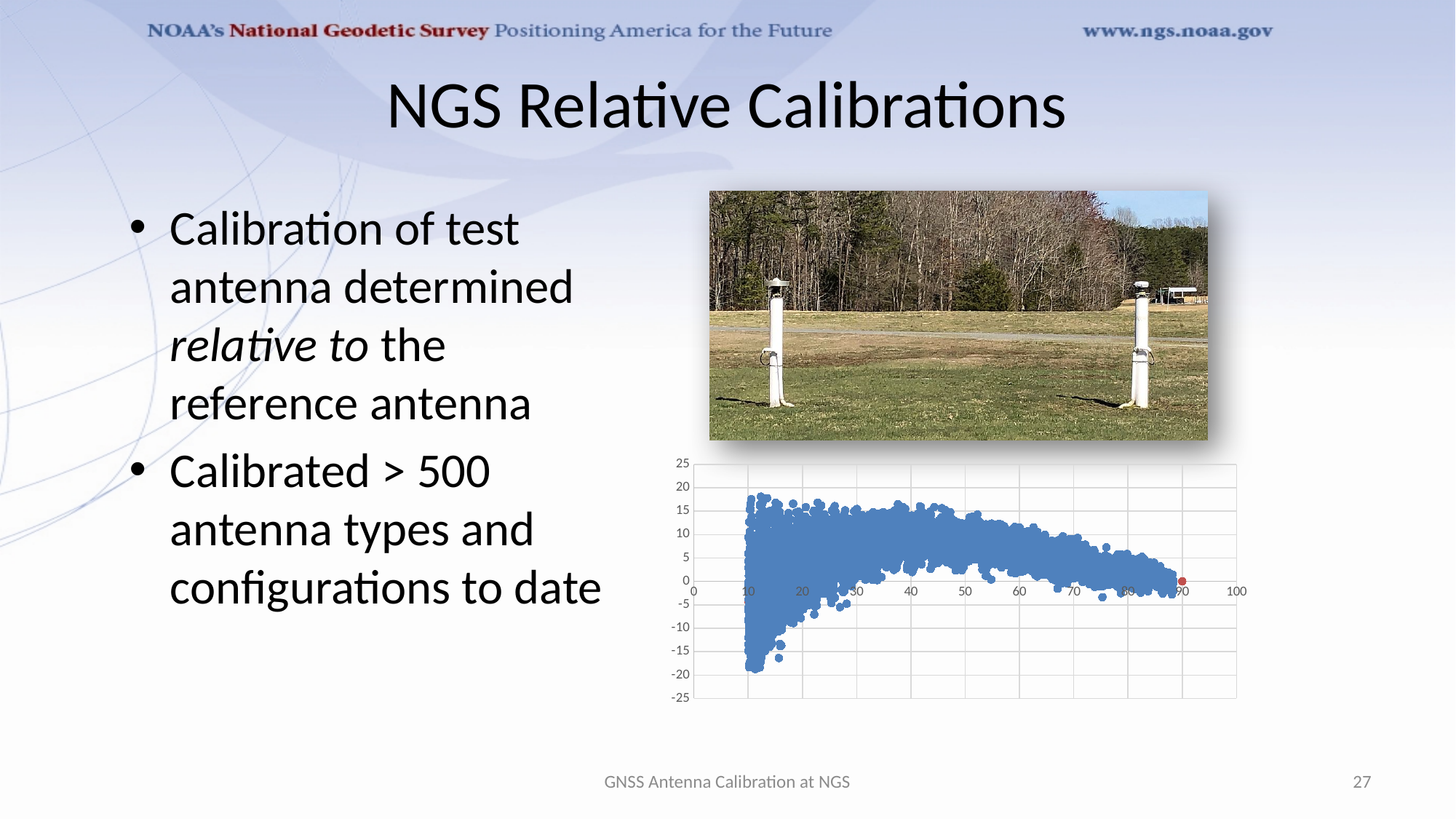
In the scatter chart, are the blue points with the lowest vertical values found near the left or the right end of the horizontal axis? left What kind of chart is shown at the bottom right of the slide? scatter chart What is the largest value labelled on the horizontal axis of the scatter chart? 100 What is the highest value labelled on the vertical axis of the scatter chart? 25 In the scatter chart, does the vertical spread of the blue points widen or narrow as the horizontal value increases from 10 to 90? narrow What is the lowest value labelled on the vertical axis of the scatter chart? -25 In the scatter chart, is the horizontal position of the leftmost blue points greater or less than 20? less In the scatter chart, is the vertical value of the red point greater or less than 10? less In the scatter chart, do any of the blue points reach a vertical value above 20? No